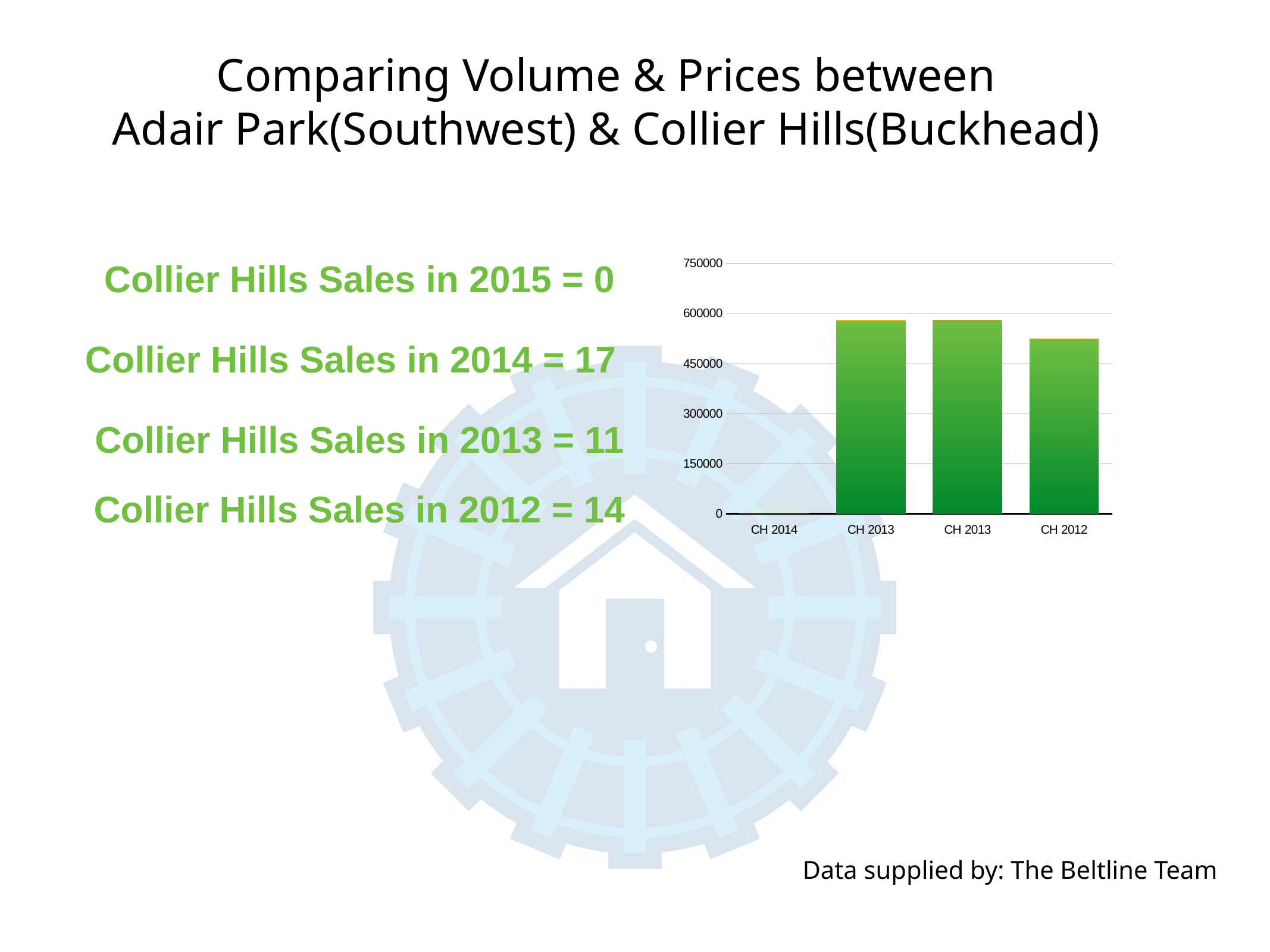
What kind of chart is shown on the slide? bar chart Is the value for CH 2012 greater or less than 600000? less Is the value for CH 2012 greater or less than 450000? greater What colour are the bars in the chart? green Which is larger, the value for CH 2012 or the value of the bar labelled CH 2013 immediately to its left? CH 2013 Which category has the lowest value in the chart? CH 2014 What is the highest tick value shown on the vertical axis of the chart? 750000 How many bars (categories) are shown on the x axis of the chart? 4 Is the value of the third bar from the left (CH 2013) greater or less than 450000? greater